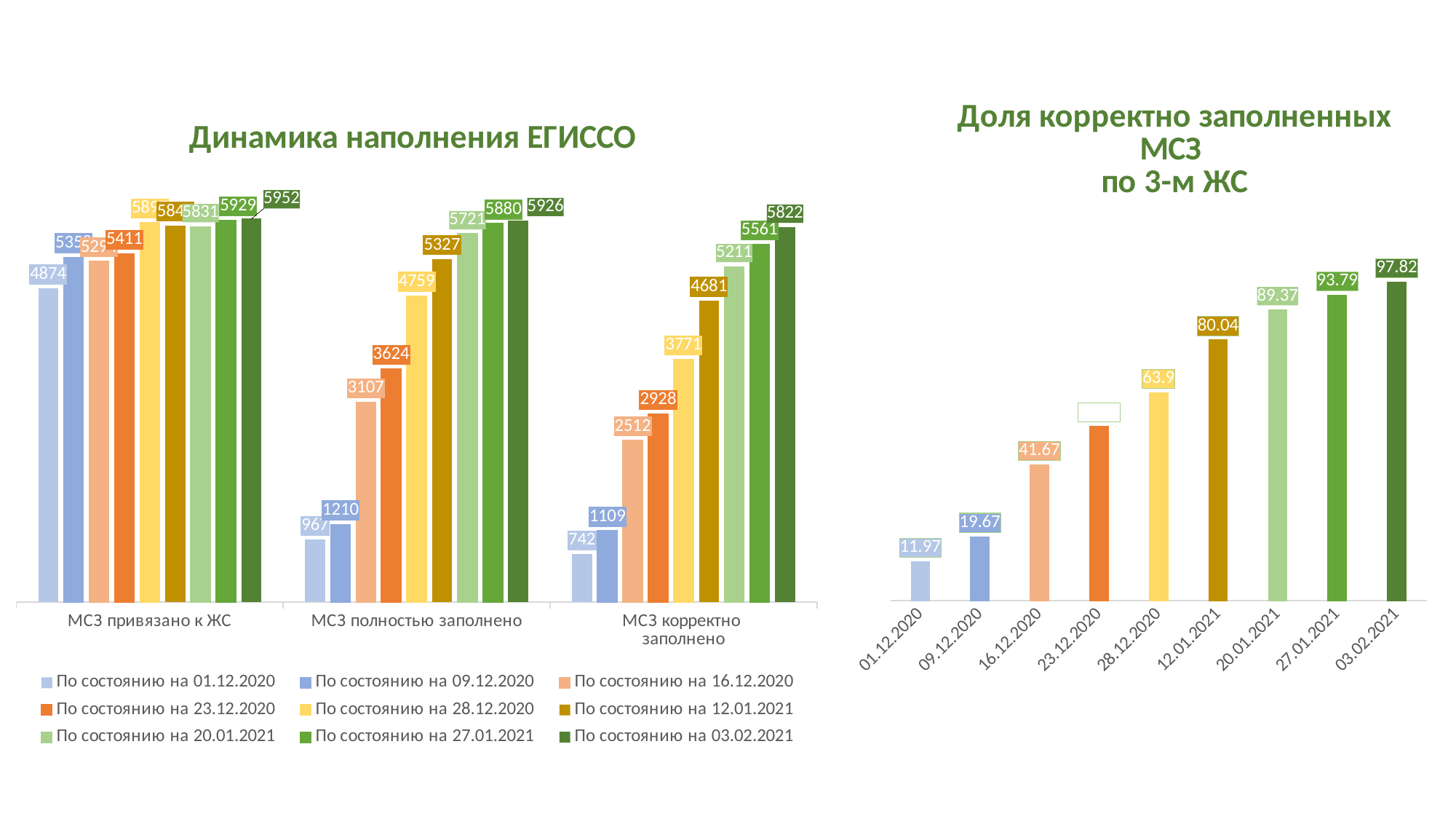
In the chart 'Динамика наполнения ЕГИССО', what is the value for 'По состоянию на 01.12.2020' in the category 'МСЗ привязано к ЖС'? 4874 In the chart 'Доля корректно заполненных МСЗ по 3-м ЖС', do the values rise or fall from left to right along the x axis? rise In the chart 'Доля корректно заполненных МСЗ по 3-м ЖС', which date has the lowest value? 01.12.2020 In the chart 'Динамика наполнения ЕГИССО', what is the difference between the values for 03.02.2021 and 27.01.2021 in the category 'МСЗ корректно заполнено'? 261 How many dates are shown on the x axis of the chart 'Доля корректно заполненных МСЗ по 3-м ЖС'? 9 In the chart 'Доля корректно заполненных МСЗ по 3-м ЖС', what is the value for 16.12.2020? 41.67 What kind of chart is 'Динамика наполнения ЕГИССО'? bar chart How many series does the legend of the chart 'Динамика наполнения ЕГИССО' list? 9 In the chart 'Динамика наполнения ЕГИССО', what is the value for 'По состоянию на 03.02.2021' in the category 'МСЗ корректно заполнено'? 5822 In the chart 'Динамика наполнения ЕГИССО', for 'По состоянию на 23.12.2020', which category has the larger value: 'МСЗ полностью заполнено' or 'МСЗ корректно заполнено'? МСЗ полностью заполнено In the chart 'Доля корректно заполненных МСЗ по 3-м ЖС', what is the value for 03.02.2021? 97.82 In the chart 'Динамика наполнения ЕГИССО', what is the value for 'По состоянию на 28.12.2020' in the category 'МСЗ полностью заполнено'? 4759